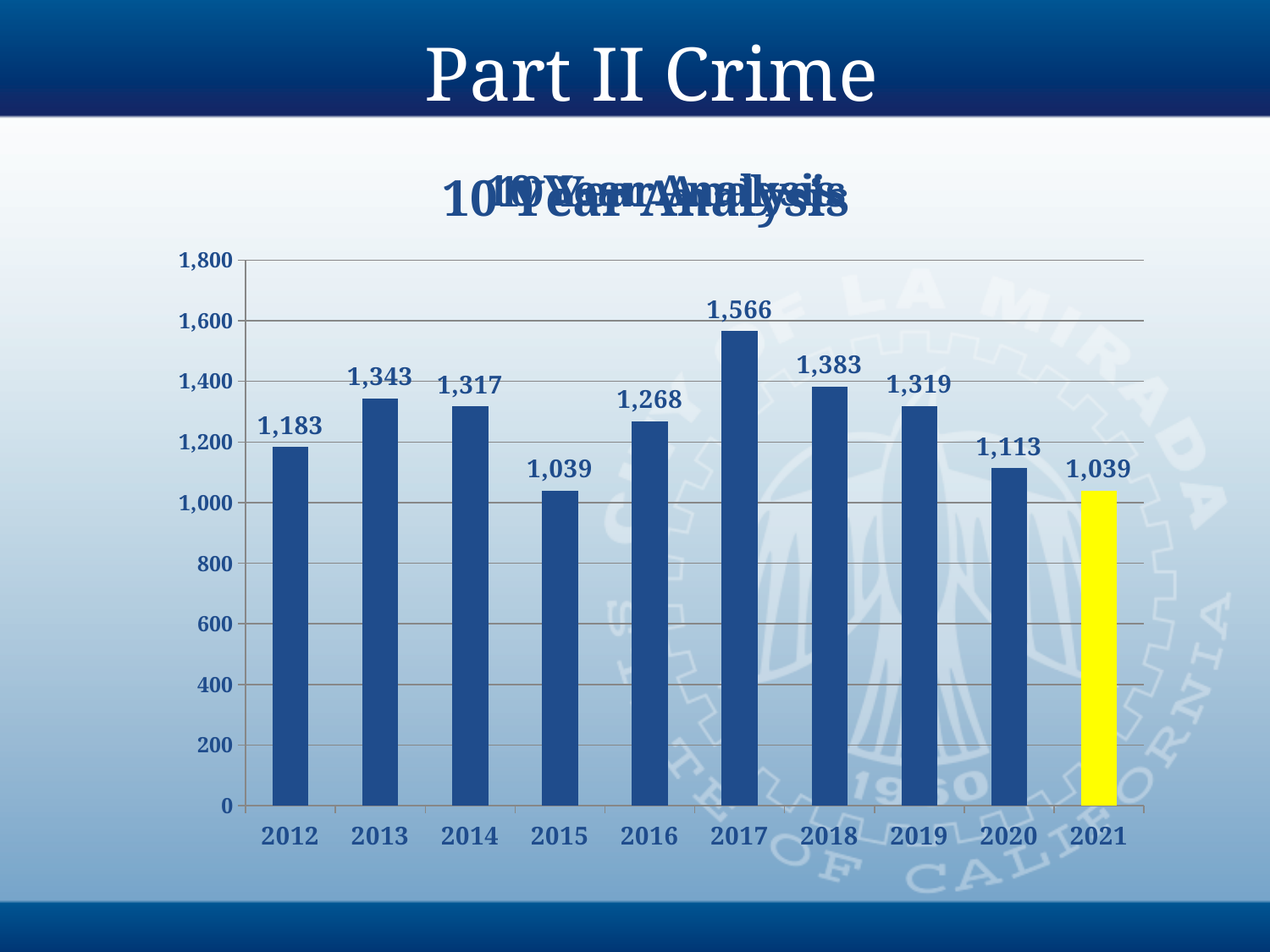
What is the difference between the values for 2017 and 2018? 183 Which is larger, the value for 2016 or the value for 2019? 2019 Which year has the highest value? 2017 Is the value for 2018 greater or less than 1,200? greater What kind of chart is shown on the slide? bar chart What is the difference between the values for 2013 and 2014? 26 What is the value for 2012? 1,183 What is the value for 2017? 1,566 Do the values rise or fall from 2017 to 2021? fall What is the value for 2020? 1,113 How many years are shown on the x axis? 10 Which year's bar is coloured yellow instead of blue? 2021